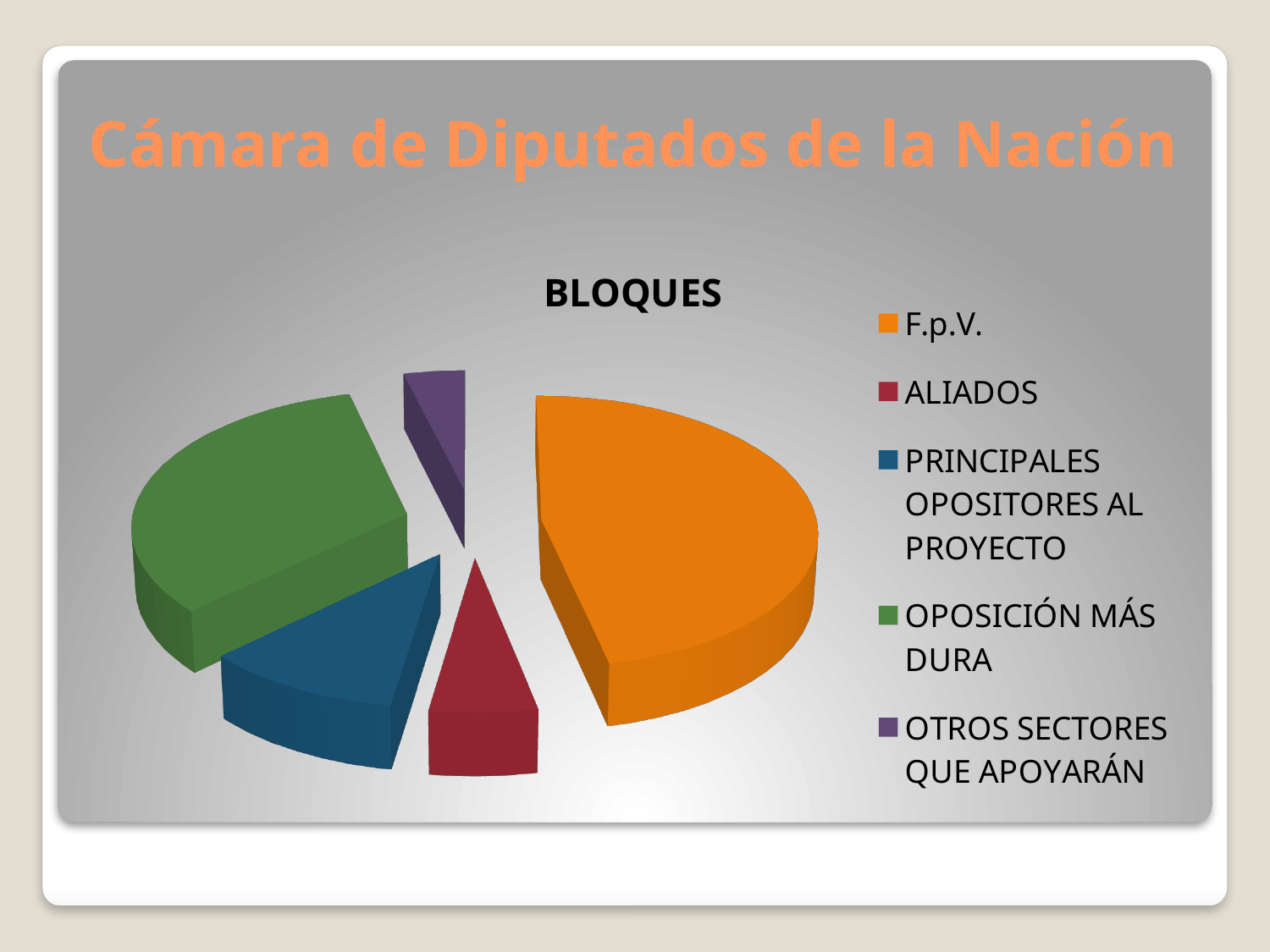
What kind of chart is shown on the slide? Pie chart How many slices does the pie chart have? 5 Which slice is larger, F.p.V. or ALIADOS? F.p.V. Which slice is larger, PRINCIPALES OPOSITORES AL PROYECTO or ALIADOS? PRINCIPALES OPOSITORES AL PROYECTO Which slice is larger, ALIADOS or OTROS SECTORES QUE APOYARÁN? ALIADOS Which category has the largest slice of the pie? F.p.V. How many categories does the legend list? 5 Which category is shown in orange in the pie chart? F.p.V. Which category has the smallest slice of the pie? OTROS SECTORES QUE APOYARÁN What is the title of the chart? BLOQUES